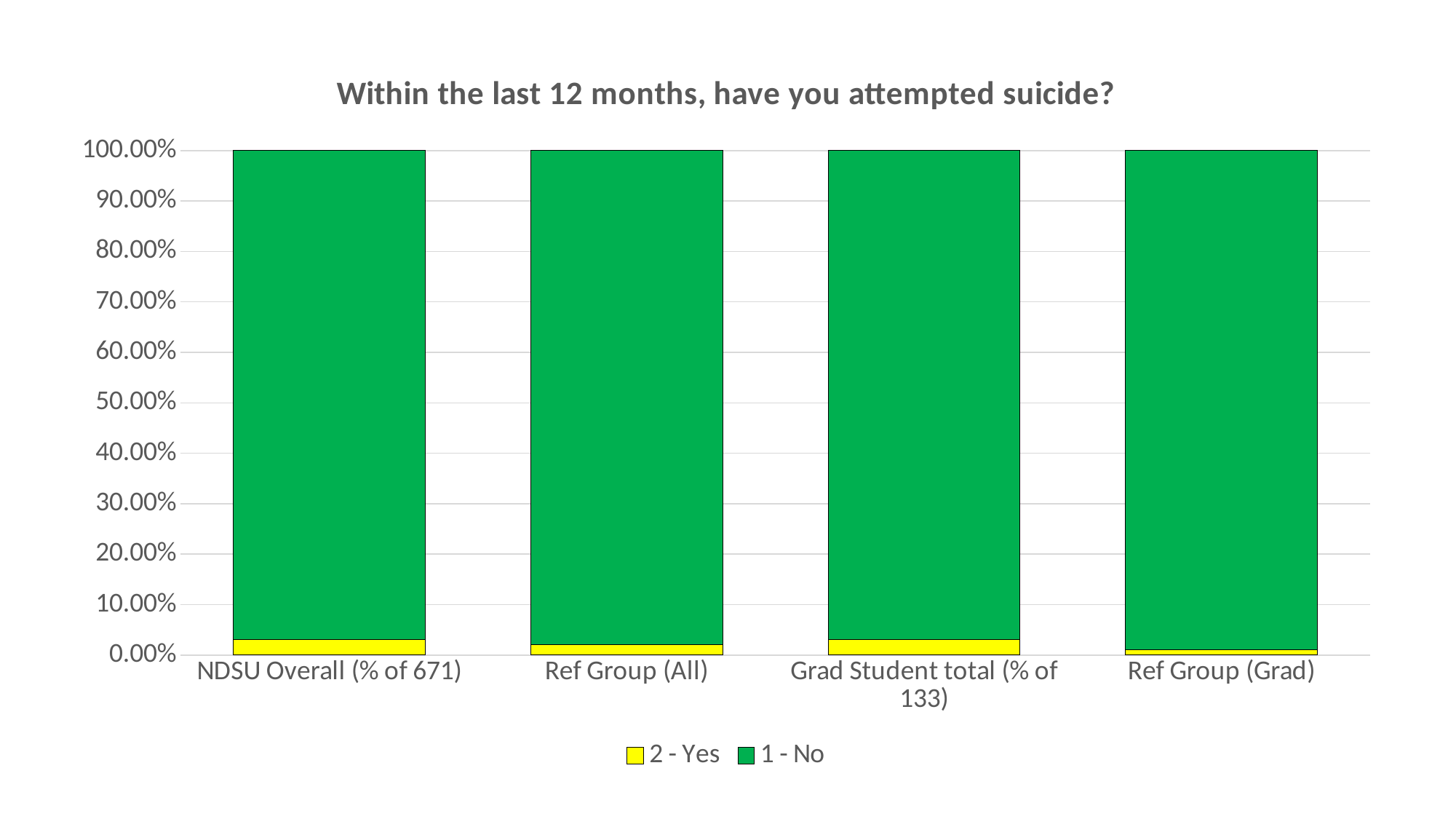
What is the total height of the stacked bar for NDSU Overall (% of 671)? 100.00% Which category has the lowest value for 2 - Yes? Ref Group (Grad) How many series does the legend list? 2 Is the value for 2 - Yes for NDSU Overall (% of 671) greater or less than 10.00%? less Which series is shown in yellow? 2 - Yes What kind of chart is shown on the slide? bar chart Is the value for 1 - No for Ref Group (All) greater or less than 90.00%? greater What is the title of the chart? Within the last 12 months, have you attempted suicide? Is the value for 2 - Yes for Ref Group (Grad) greater or less than 10.00%? less Which is larger, the 1 - No value for Ref Group (Grad) or for Grad Student total (% of 133)? Ref Group (Grad) Which is larger, the 2 - Yes value for Grad Student total (% of 133) or for Ref Group (Grad)? Grad Student total (% of 133) How many categories are shown on the x axis? 4